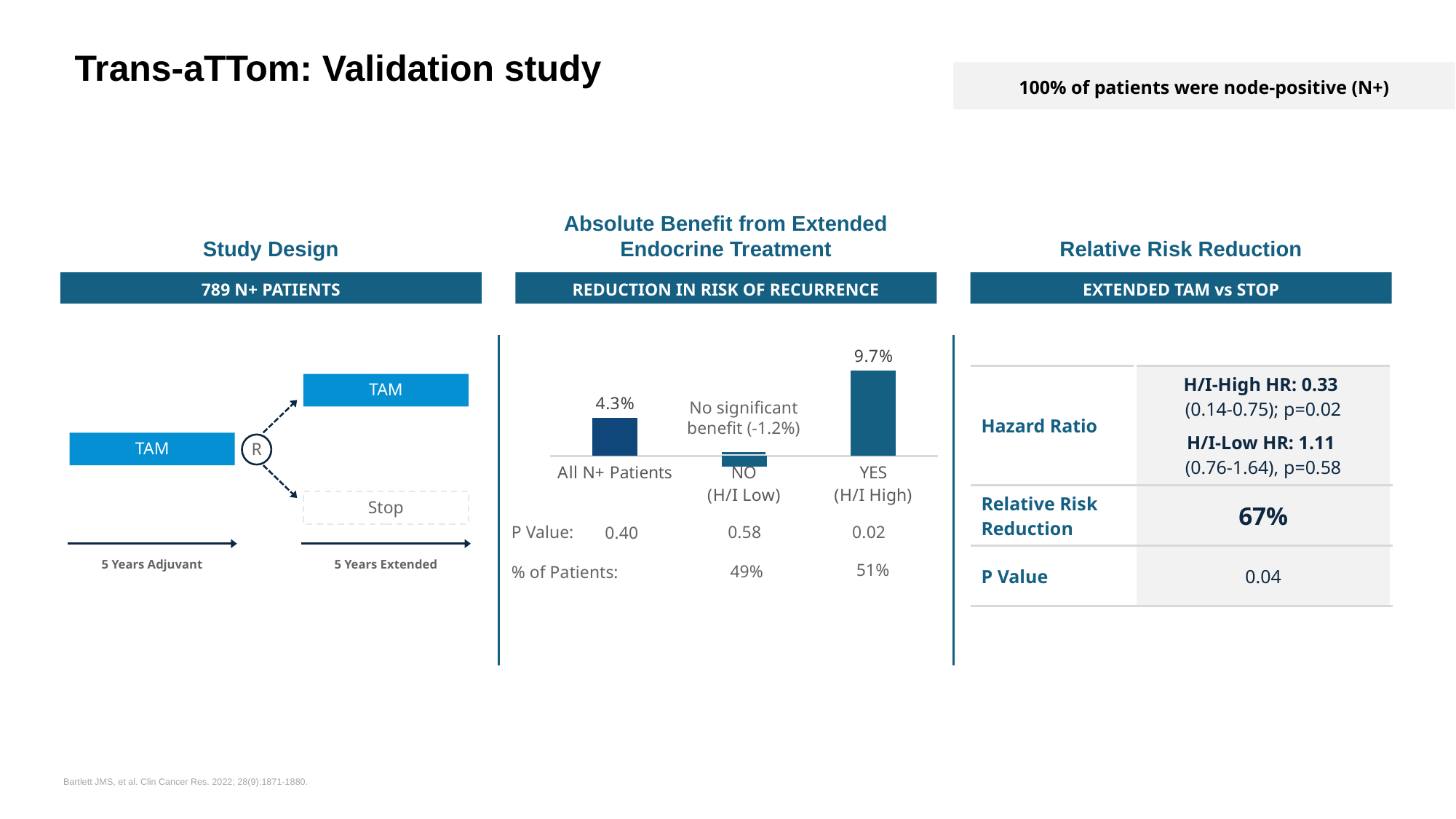
What P value is listed under the YES (H/I High) bar in the Reduction in Risk of Recurrence chart? 0.02 What percentage of patients is listed for the NO (H/I Low) group in the Reduction in Risk of Recurrence chart? 49% What is the title printed above the Reduction in Risk of Recurrence chart? Absolute Benefit from Extended Endocrine Treatment What is the value shown for the YES (H/I High) bar in the Reduction in Risk of Recurrence chart? 9.7% Which category has the lowest value in the Reduction in Risk of Recurrence chart? NO (H/I Low) Which category has the highest bar in the Reduction in Risk of Recurrence chart? YES (H/I High) In the Reduction in Risk of Recurrence chart, which is larger: the value for All N+ Patients or the value for YES (H/I High)? YES (H/I High) What value is given for the NO (H/I Low) group in the Reduction in Risk of Recurrence chart? -1.2% What is the absolute benefit value shown for All N+ Patients in the Reduction in Risk of Recurrence chart? 4.3% What kind of chart is used to show the Reduction in Risk of Recurrence? Bar chart What is the difference between the YES (H/I High) value and the All N+ Patients value in the Reduction in Risk of Recurrence chart? 5.4% How many categories are plotted in the Reduction in Risk of Recurrence chart? 3